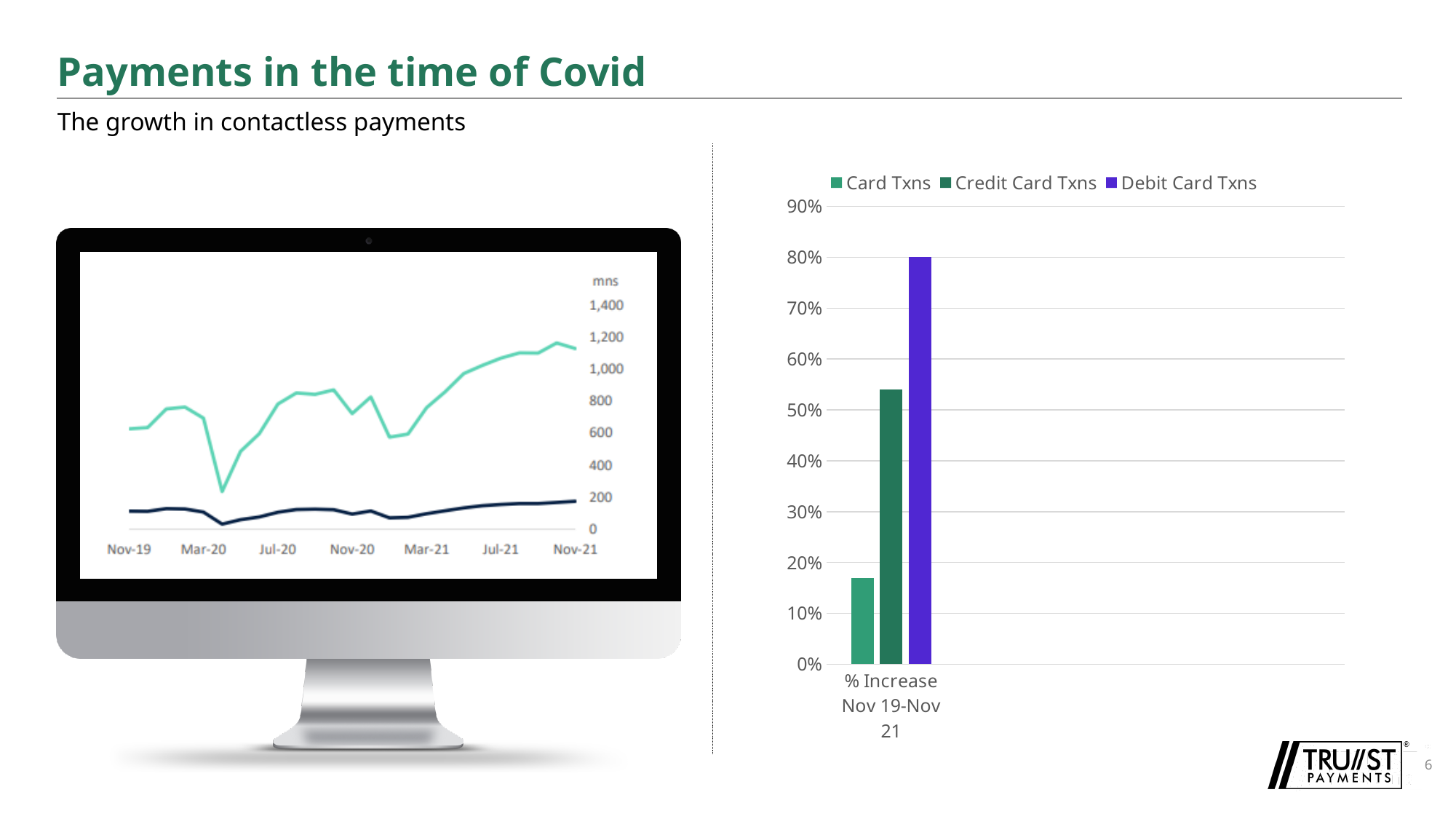
What kind of chart is shown on the monitor screen on the left side of the slide? line chart In the right-hand bar chart, is the value for Card Txns greater or less than 20%? less In the right-hand bar chart, which series has the highest % increase from Nov 19 to Nov 21? Debit Card Txns What unit label is shown at the top of the y axis of the line chart on the left? mns In the right-hand bar chart, is the value for Credit Card Txns greater or less than 50%? greater In the right-hand bar chart, which is larger: Credit Card Txns or Card Txns? Credit Card Txns How many series does the legend of the right-hand bar chart list? 3 What kind of chart is the chart on the right side of the slide? bar chart In the right-hand bar chart, what is the % increase for Debit Card Txns? 80% How many categories are shown on the x axis of the right-hand bar chart? 1 In the right-hand bar chart, which series has the lowest % increase from Nov 19 to Nov 21? Card Txns In the line chart on the left, does the upper (green) line overall rise or fall from Nov-19 to Nov-21? rise